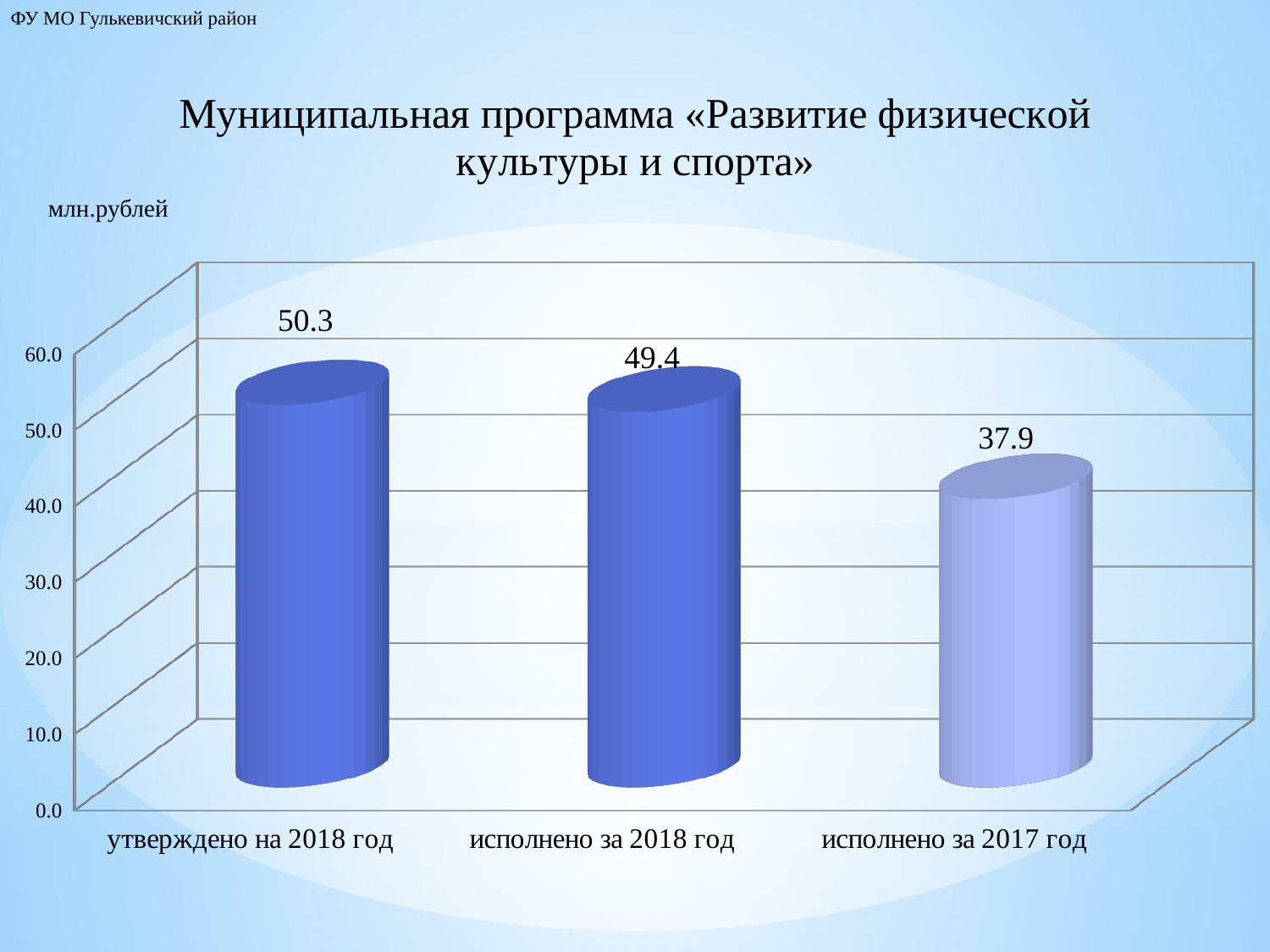
Which category has the lowest value? исполнено за 2017 год What is the value for «исполнено за 2017 год»? 37.9 How many categories are shown in the chart? 3 What kind of chart is shown on the slide? bar chart What is the difference between «утверждено на 2018 год» and «исполнено за 2018 год»? 0.9 What is the value for «утверждено на 2018 год»? 50.3 Which is larger: «исполнено за 2018 год» or «исполнено за 2017 год»? исполнено за 2018 год What is the value for «исполнено за 2018 год»? 49.4 Which category has the highest value? утверждено на 2018 год Is the value for «исполнено за 2017 год» greater or less than 40.0? less What is the difference between «исполнено за 2018 год» and «исполнено за 2017 год»? 11.5 What unit of measurement is indicated above the chart? млн.рублей